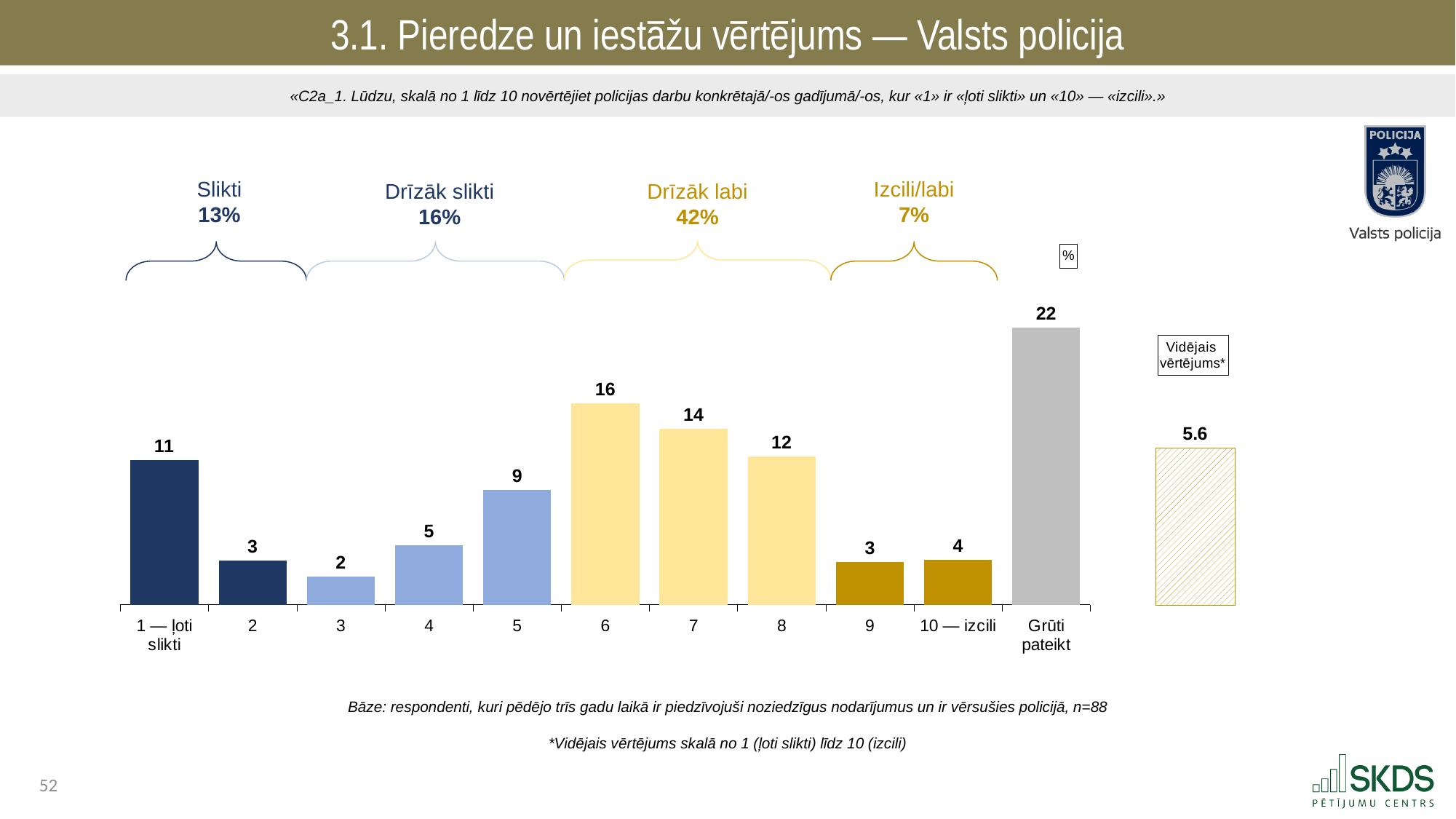
What is the difference between the values for rating 6 and rating 8? 4 What is the combined share for the "Drīzāk labi" group shown above the chart? 42% Which rating category has the lowest value? 3 How many bars are in the main rating chart (including "Grūti pateikt")? 11 What value is shown for the rating 6? 16 What percentage of respondents gave the rating "1 — ļoti slikti"? 11 Among the ratings 1 to 10, which rating has the highest value? 6 What type of chart is shown on the slide? bar chart Which is larger, the value for rating 5 or the value for rating 4? rating 5 What is the average rating (Vidējais vērtējums) shown on the slide? 5.6 Which bar has the highest value in the chart? Grūti pateikt What value is shown for the "Grūti pateikt" bar? 22